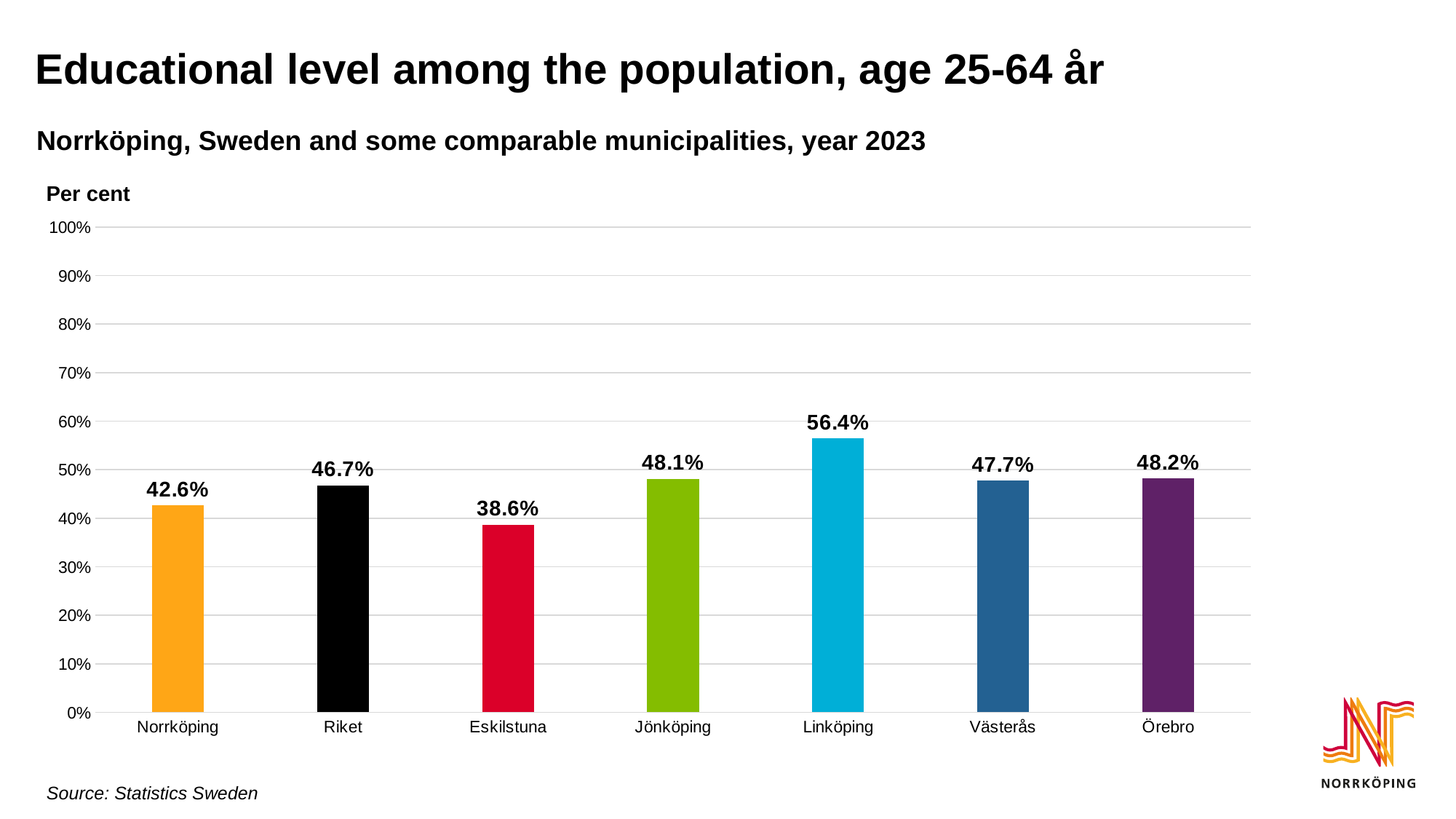
Which category has the lowest value? Eskilstuna What is the value for Eskilstuna? 38.6% Which is larger, the value for Jönköping or the value for Västerås? Jönköping Which category has the highest value? Linköping What is the value for Linköping? 56.4% What is the value for Norrköping? 42.6% What is the value for Riket? 46.7% Is the value for Örebro greater or less than 40%? greater What is the difference between the values for Linköping and Norrköping? 13.8 percentage points What is the source cited for the chart? Statistics Sweden What kind of chart is shown on the slide? Bar chart How many categories are shown on the x axis? 7